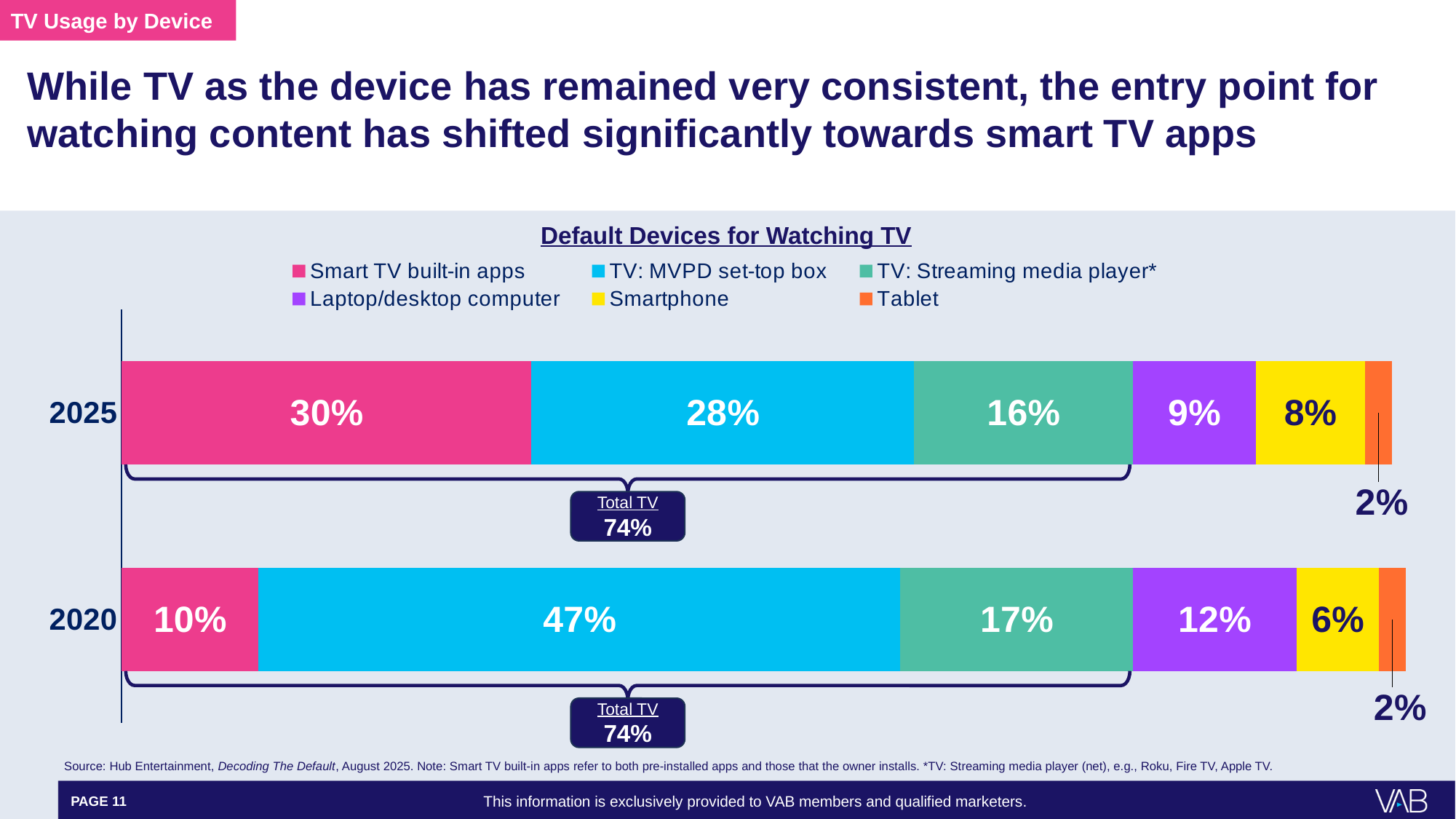
What percentage of respondents used Smart TV built-in apps as their default device in 2025? 30% What was the Smartphone share in 2020? 6% What was the Laptop/desktop computer share in 2025? 9% Which device had the largest share in 2020? TV: MVPD set-top box What is the title of the chart? Default Devices for Watching TV By how many percentage points did the Smart TV built-in apps share change from 2020 to 2025? 20 percentage points Which was larger in 2025: Smart TV built-in apps or TV: MVPD set-top box? Smart TV built-in apps What type of chart is shown on the slide? Stacked bar chart Which device had the smallest share in 2025? Tablet How many device categories does the legend list? 6 What was the share for TV: MVPD set-top box in 2020? 47% What was the Total TV share in 2025? 74%